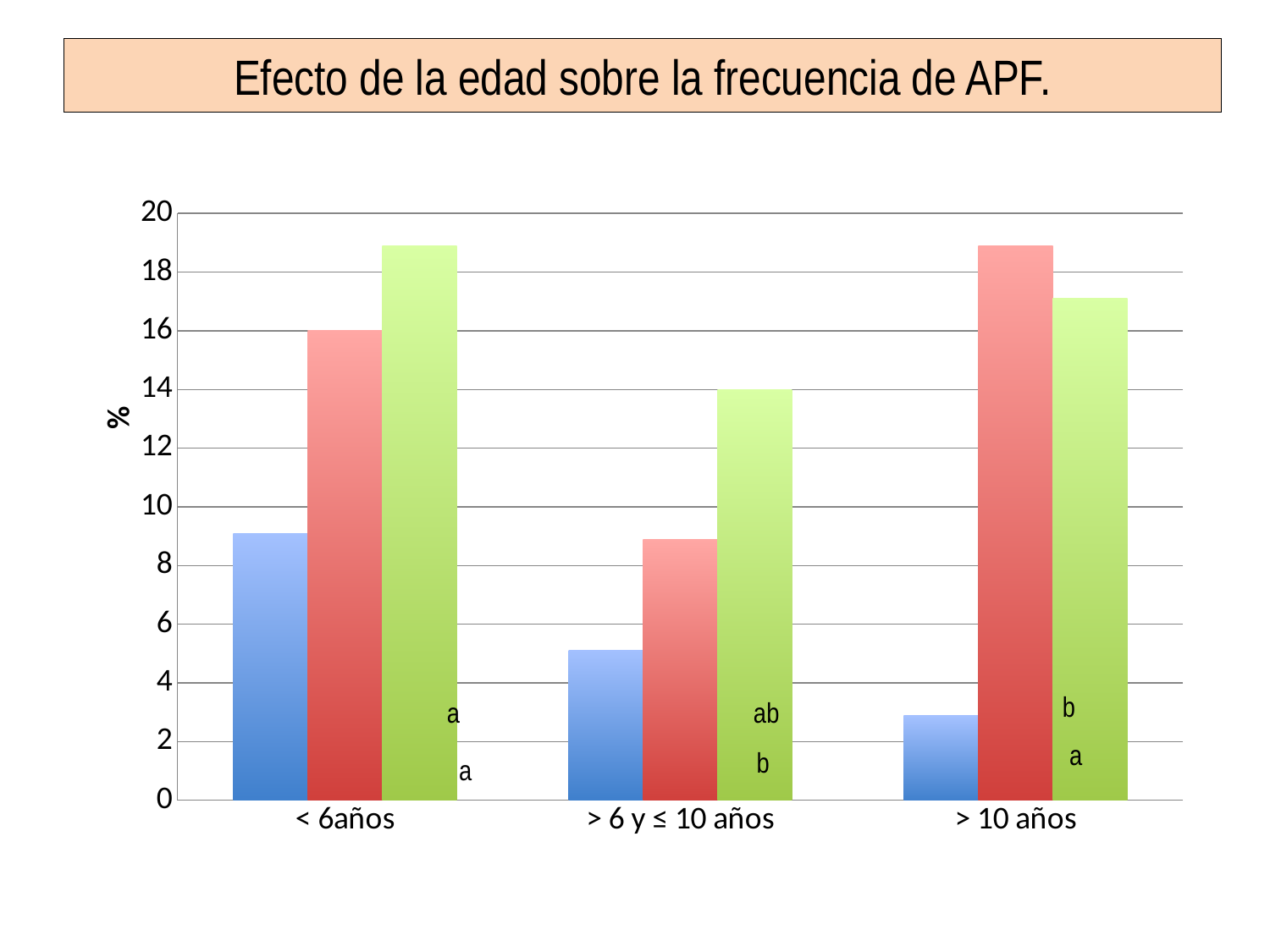
In the '< 6años' category, which is larger, the red bar or the green bar? the green bar Do the blue bars rise or fall as age increases along the x axis? fall For which age category is the red bar lowest? > 6 y ≤ 10 años Is the value of the blue bar for '> 10 años' greater or less than 4? less How many age categories are shown on the x axis? 3 What is the title of the chart? Efecto de la edad sobre la frecuencia de APF. Is the value of the red bar for '> 10 años' greater or less than 18? greater What is the value of the red bar for the '< 6años' category? 16 What is the value of the green bar for the '> 6 y ≤ 10 años' category? 14 What is the label on the y axis? % For which age category is the blue bar highest? < 6años What kind of chart is shown on the slide? bar chart